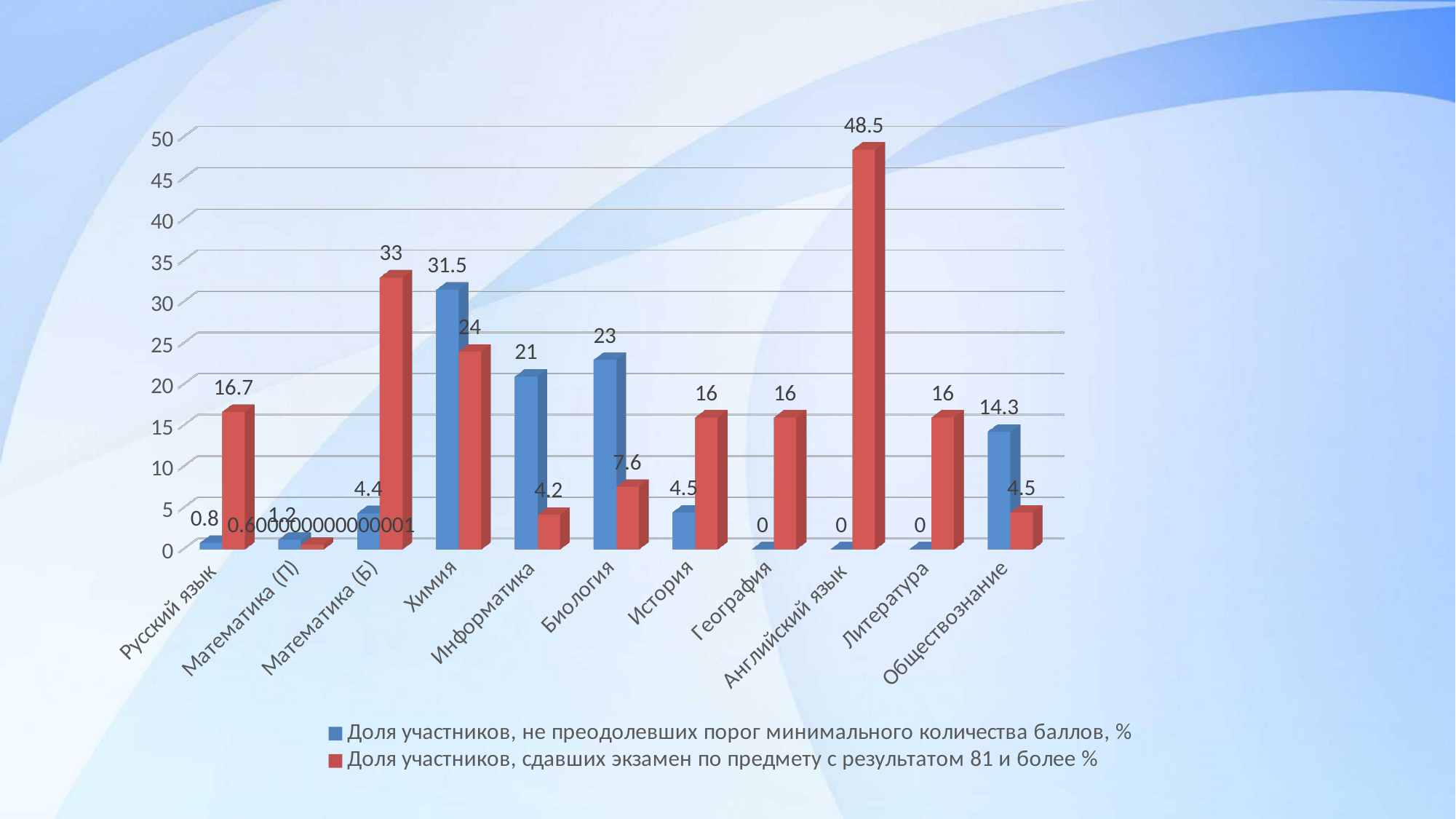
Which subject has the highest value in the series 'Доля участников, не преодолевших порог минимального количества баллов, %'? Химия How many subject categories are shown on the x axis? 11 What is the value for Обществознание in the series 'Доля участников, не преодолевших порог минимального количества баллов, %'? 14.3 What type of chart is shown on the slide? bar chart What is the value for Английский язык in the series 'Доля участников, сдавших экзамен по предмету с результатом 81 и более %'? 48.5 What is the value for Химия in the series 'Доля участников, не преодолевших порог минимального количества баллов, %'? 31.5 What is the difference between the two series values for Биология (23 and 7.6)? 15.4 Is the value for Математика (Б) in the series 'Доля участников, сдавших экзамен по предмету с результатом 81 и более %' greater or less than 30? greater For Информатика, which series has the larger value: 'не преодолевших порог' or 'с результатом 81 и более'? Доля участников, не преодолевших порог минимального количества баллов, % How many series does the legend list? 2 Which subject has the highest value in the series 'Доля участников, сдавших экзамен по предмету с результатом 81 и более %'? Английский язык Which colour represents the series 'Доля участников, сдавших экзамен по предмету с результатом 81 и более %'? red